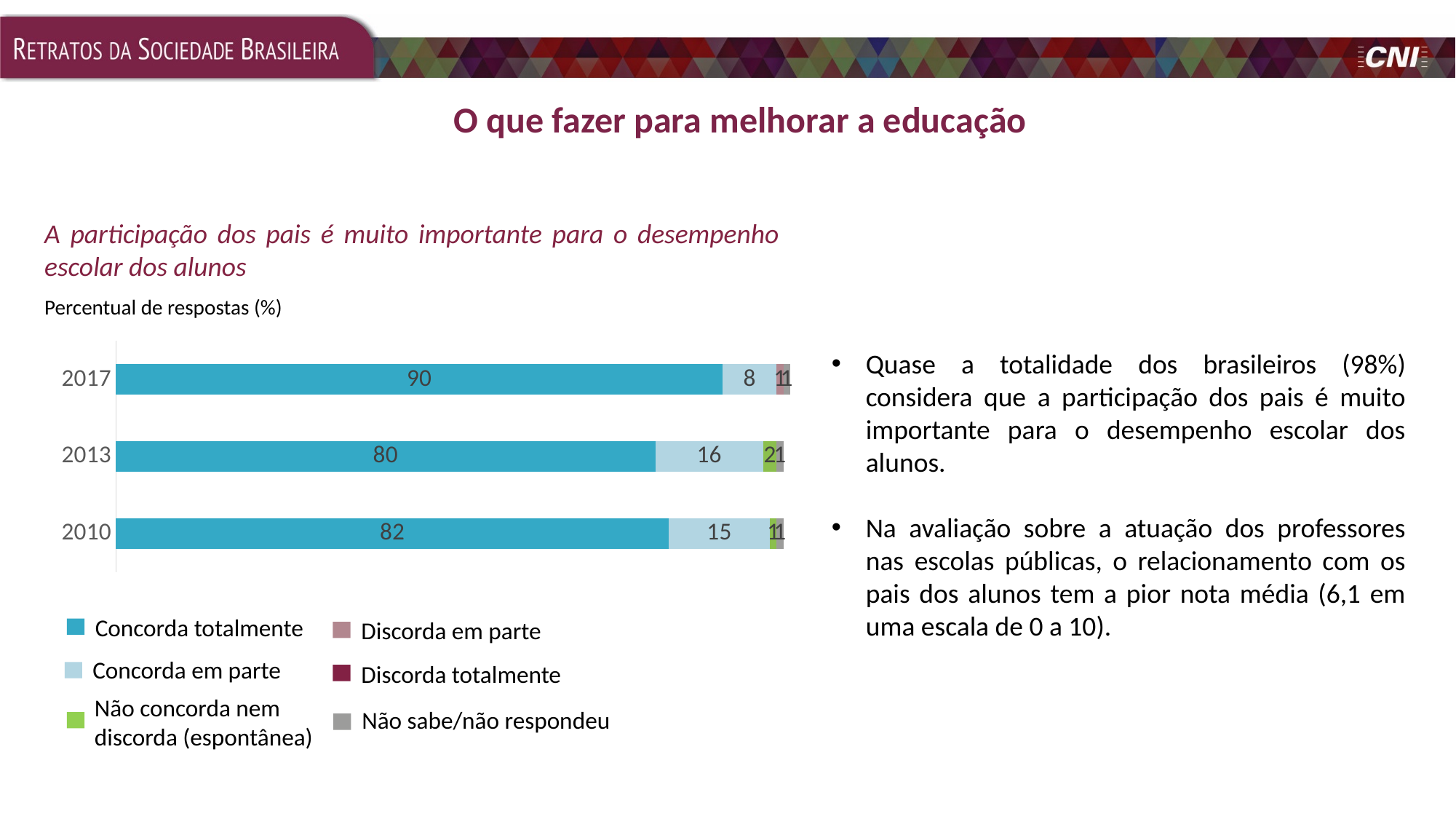
What is the difference between the "Concorda totalmente" values for 2017 and 2013? 10 What is the title of the chart on the slide? A participação dos pais é muito importante para o desempenho escolar dos alunos In which year was the share of "Concorda totalmente" highest? 2017 In which year was the share of "Concorda totalmente" lowest? 2013 What is the value for "Concorda em parte" in 2017? 8 How many years are shown in the chart? 3 How many series does the legend list? 6 What is the value for "Concorda totalmente" in 2010? 82 Which year has a larger "Concorda em parte" value, 2013 or 2010? 2013 What percentage of respondents answered "Concorda totalmente" in 2017? 90 What kind of chart is shown on the slide? Stacked bar chart What percentage of respondents answered "Concorda em parte" in 2013? 16